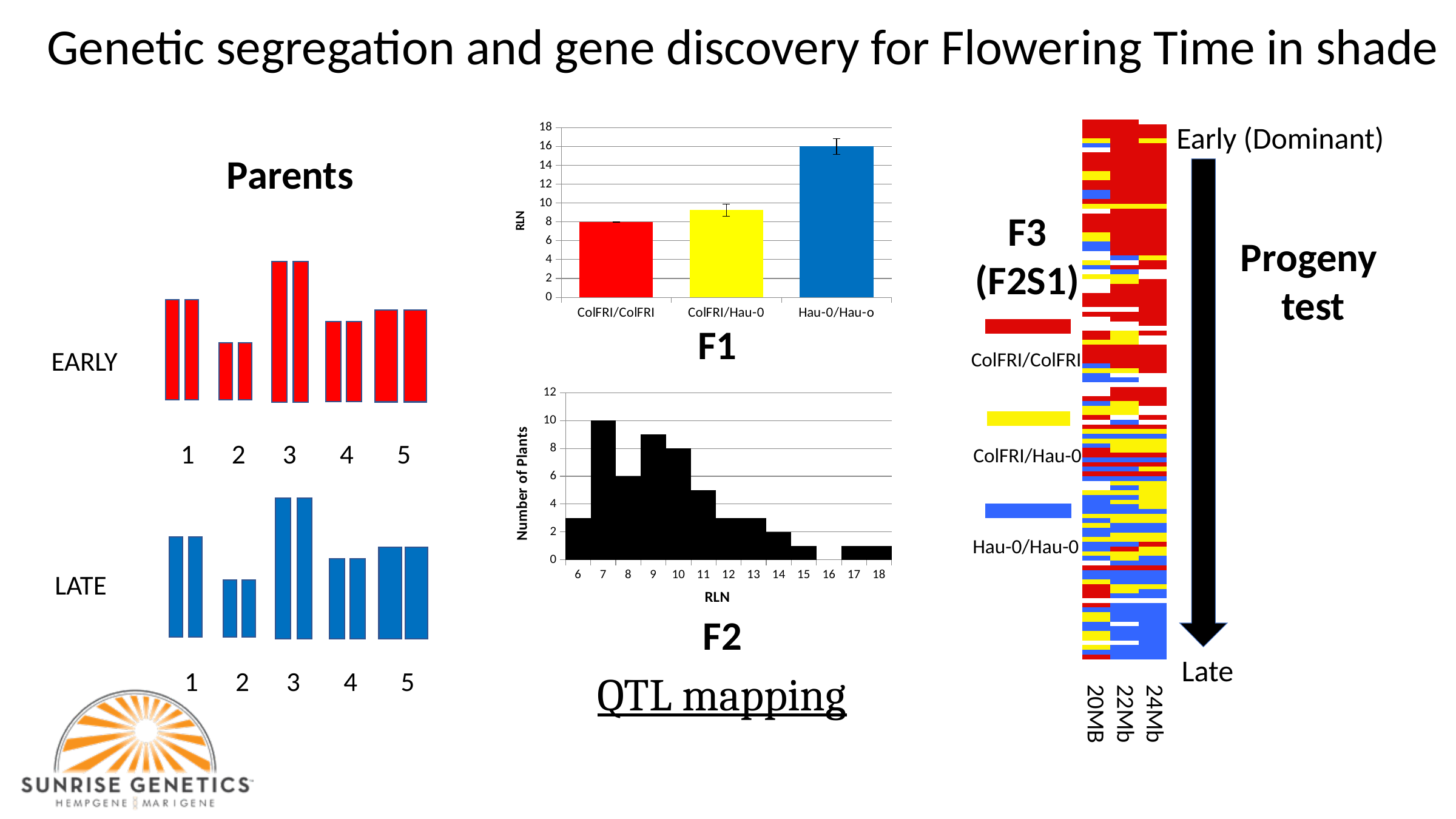
In the F1 chart, what is the RLN value for ColFRI/ColFRI? 8 In the F1 chart, which category has the highest RLN? Hau-0/Hau-o In the F2 chart, how many plants have an RLN of 10? 8 In the F1 chart, how many categories are shown on the x axis? 3 In the F1 chart, is the RLN value for ColFRI/Hau-0 greater or less than 8? greater In the F2 chart, how many plants have an RLN of 7? 10 In the F1 chart, which category has the lowest RLN? ColFRI/ColFRI In the F1 chart, what is the difference in RLN between Hau-0/Hau-o and ColFRI/ColFRI? 8 What kind of chart is the F2 chart? bar chart In the F1 chart, what is the RLN value for Hau-0/Hau-o? 16 In the F2 chart, is the number of plants with an RLN of 9 greater or less than 8? greater In the F2 chart, which RLN value has the highest number of plants? 7